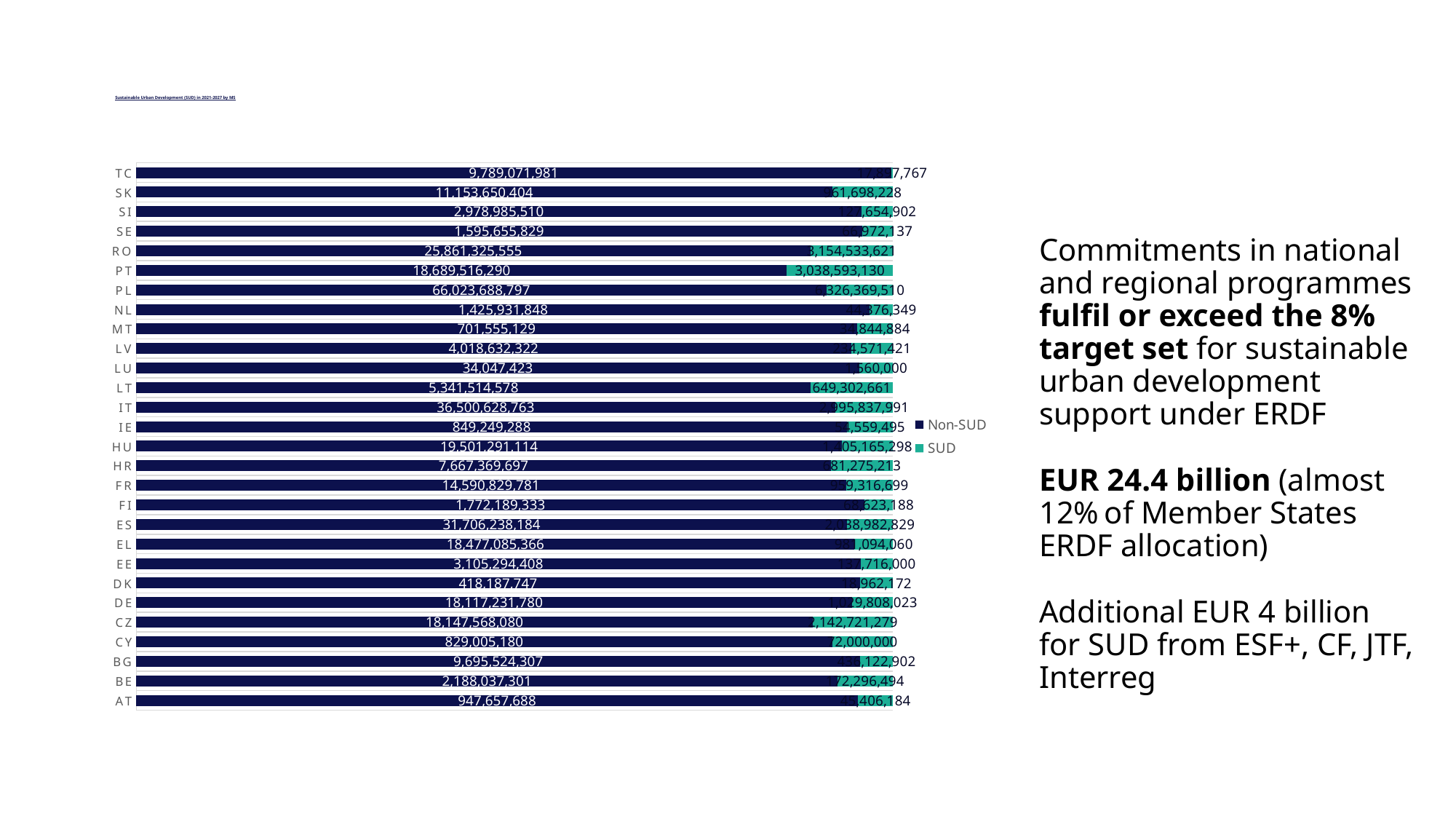
Which member state has the highest Non-SUD value? PL What type of chart is shown on the slide? bar chart Which has the larger Non-SUD value, PL or IT? PL How many member states (categories) are shown on the chart? 28 What is the Non-SUD value for LU? 34,047,423 What is the SUD value for CY? 72,000,000 Which legend entry is shown in the teal/green colour? SUD What is the SUD value for PT? 3,038,593,130 What is the difference between the Non-SUD values for RO and PT? 7,171,809,265 Which member state has the lowest Non-SUD value? LU How many series does the chart legend list? 2 What is the Non-SUD value for PL? 66,023,688,797